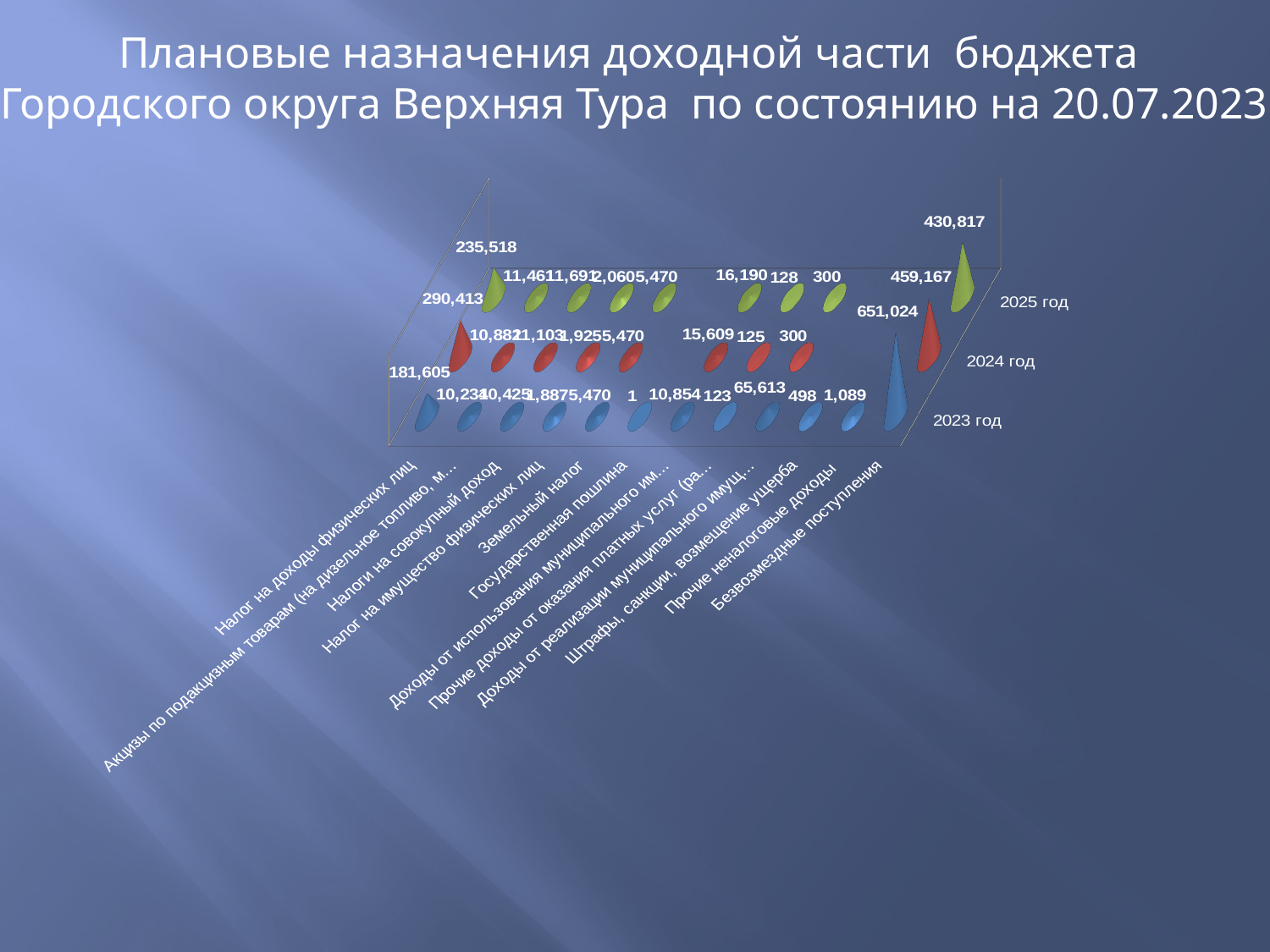
What is the value for Безвозмездные поступления in 2025 год? 430,817 What is the value for Налог на доходы физических лиц in 2023 год? 181,605 What is the value for Налог на доходы физических лиц in 2024 год? 290,413 How many revenue categories are plotted along the x axis? 12 Which category has the highest value in the 2023 год series? Безвозмездные поступления Which is larger for Безвозмездные поступления: the 2023 год value or the 2025 год value? 2023 год How many series does the chart show (years)? 3 What is the difference between the 2024 год and 2023 год values for Налог на доходы физических лиц? 108,808 Does the value for Налоги на совокупный доход rise or fall from 2023 год to 2025 год? rise What is the value for Земельный налог in 2025 год? 5,470 What is the value for Безвозмездные поступления in 2023 год? 651,024 Which years are shown as series in the chart? 2023 год, 2024 год, 2025 год